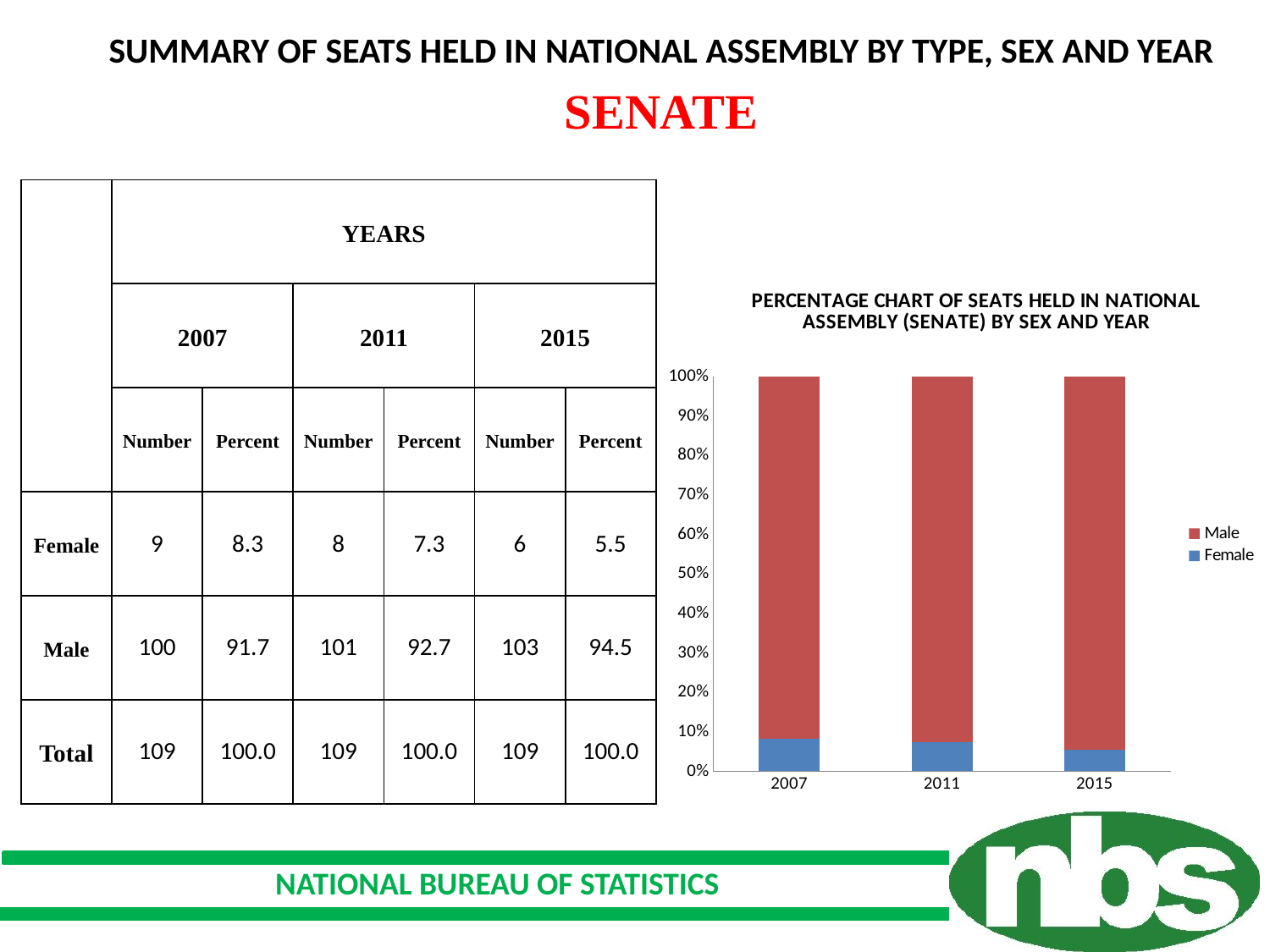
How many years are shown on the x axis of the chart? 3 Is the Female share larger in 2007 or in 2015? 2007 Which colour represents Female in the chart? blue What is the title of the chart? PERCENTAGE CHART OF SEATS HELD IN NATIONAL ASSEMBLY (SENATE) BY SEX AND YEAR How many series does the chart legend list? 2 What kind of chart is shown on the slide? stacked bar chart Is the Female share for 2015 greater or less than 10%? less Is the top of the Male segment for 2011 greater or less than 90%? greater Is the Female share for 2007 greater or less than 5%? greater What is the total height of the stacked bar for 2007? 100% Which year has the smallest Female share in the chart? 2015 Does the Female share rise or fall from 2007 to 2015? fall